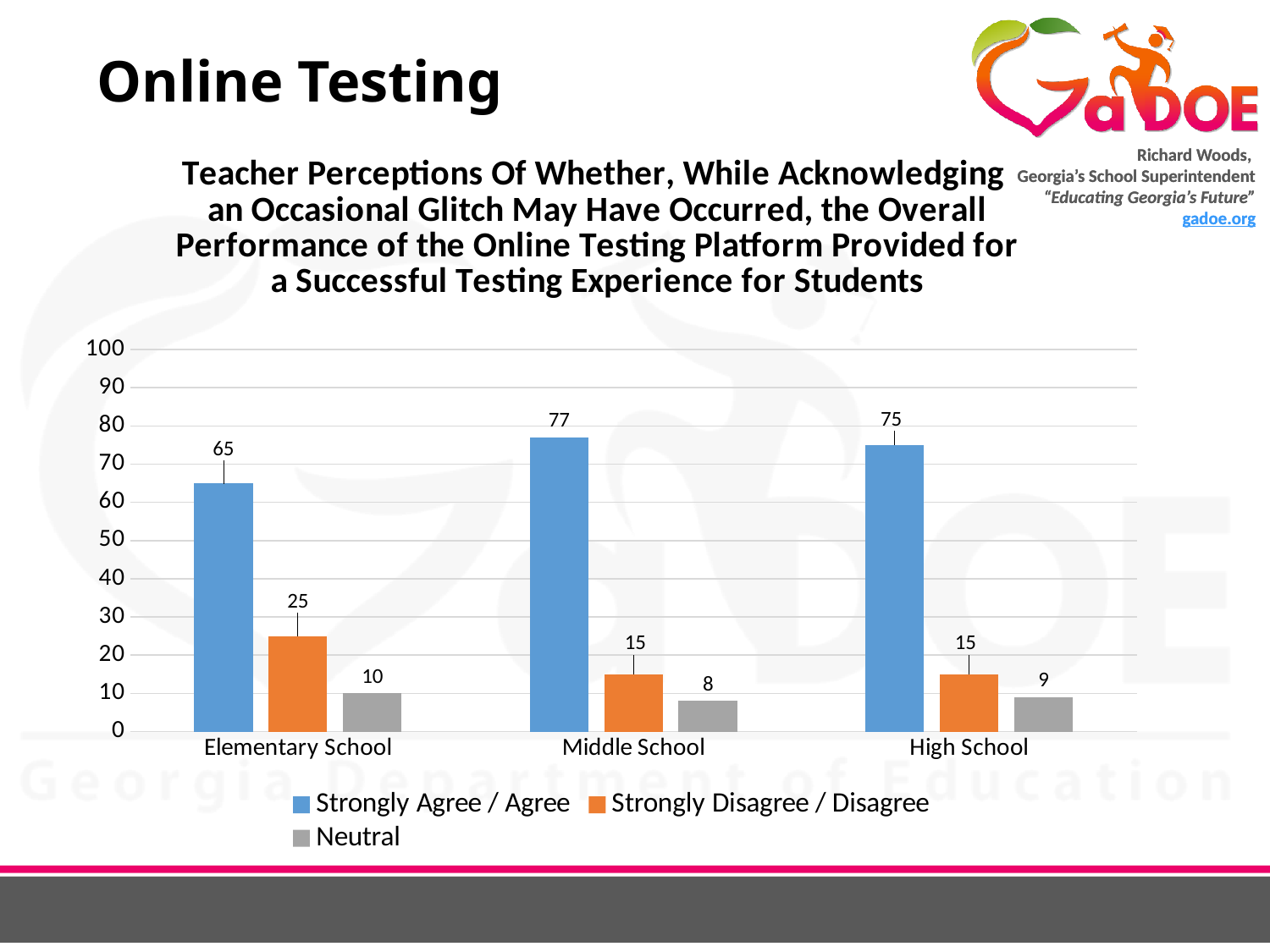
What is the difference between the Strongly Disagree / Disagree and Neutral values for Elementary School? 15 What is the Neutral value for High School? 9 Which school level has the highest Strongly Agree / Agree value? Middle School What is the Strongly Disagree / Disagree value for Middle School? 15 What is the Strongly Agree / Agree value for Elementary School? 65 Which school level has the lowest Neutral value? Middle School How many series does the legend list? 3 Which is larger: the Strongly Disagree / Disagree value for Elementary School or for High School? Elementary School What kind of chart is shown on the slide? Bar chart Which colour represents the Neutral series in the legend? Gray What is the difference between the Strongly Agree / Agree values for Middle School and Elementary School? 12 How many school levels are shown on the x axis? 3